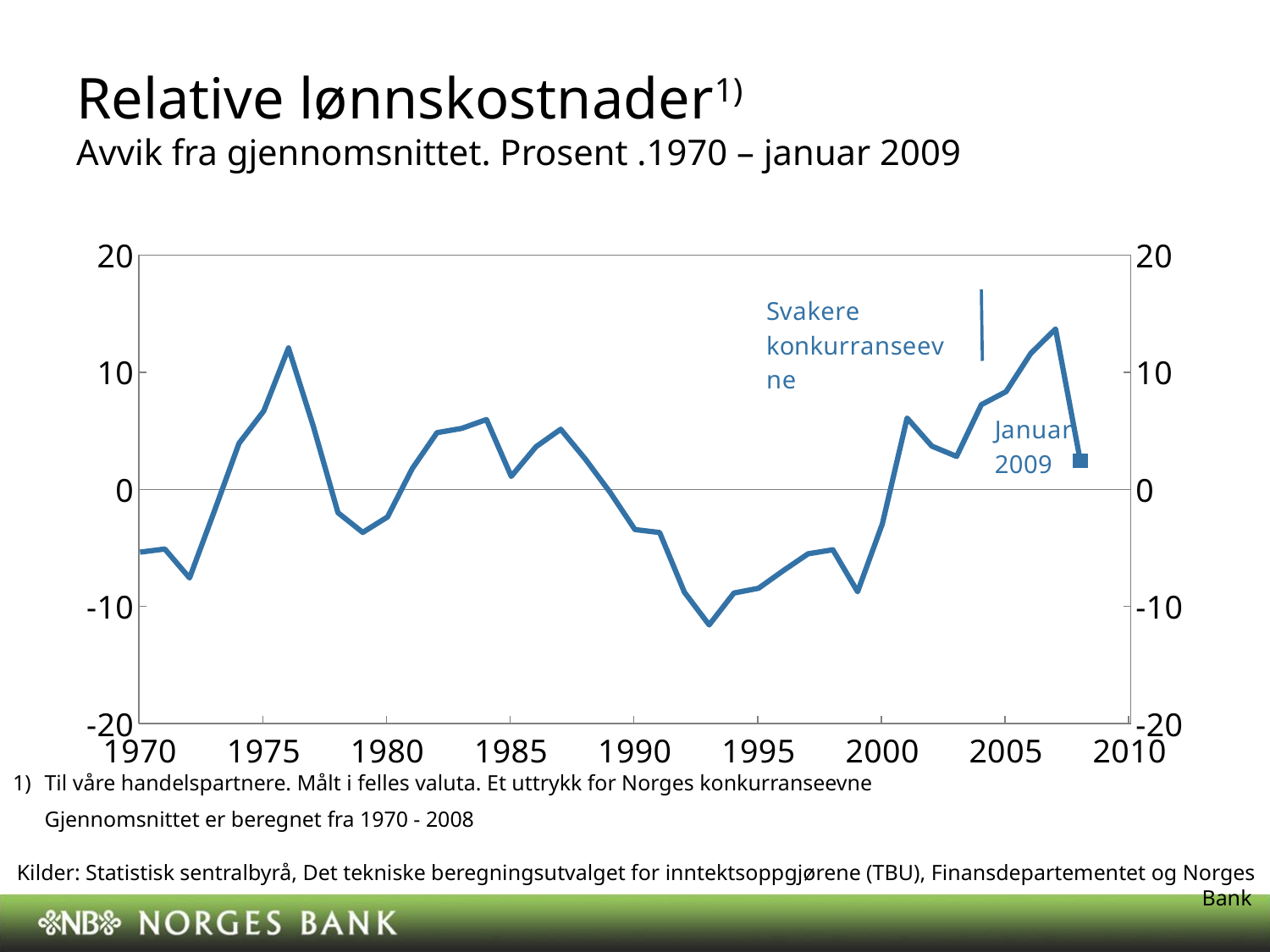
In which year does the line reach its lowest value? 1993 Is the value for January 2009 greater or less than 0? greater Is the value for 1976 greater or less than 10? greater Is the value for 2007 greater or less than 10? greater Does the line rise or fall between 2007 and January 2009? fall What is the title of the chart on the slide? Relative lønnskostnader What annotation text is written in the upper right area of the chart? Svakere konkurranseevne Which is larger, the value for 1976 or the value for 1993? 1976 What kind of chart is shown on the slide? line chart